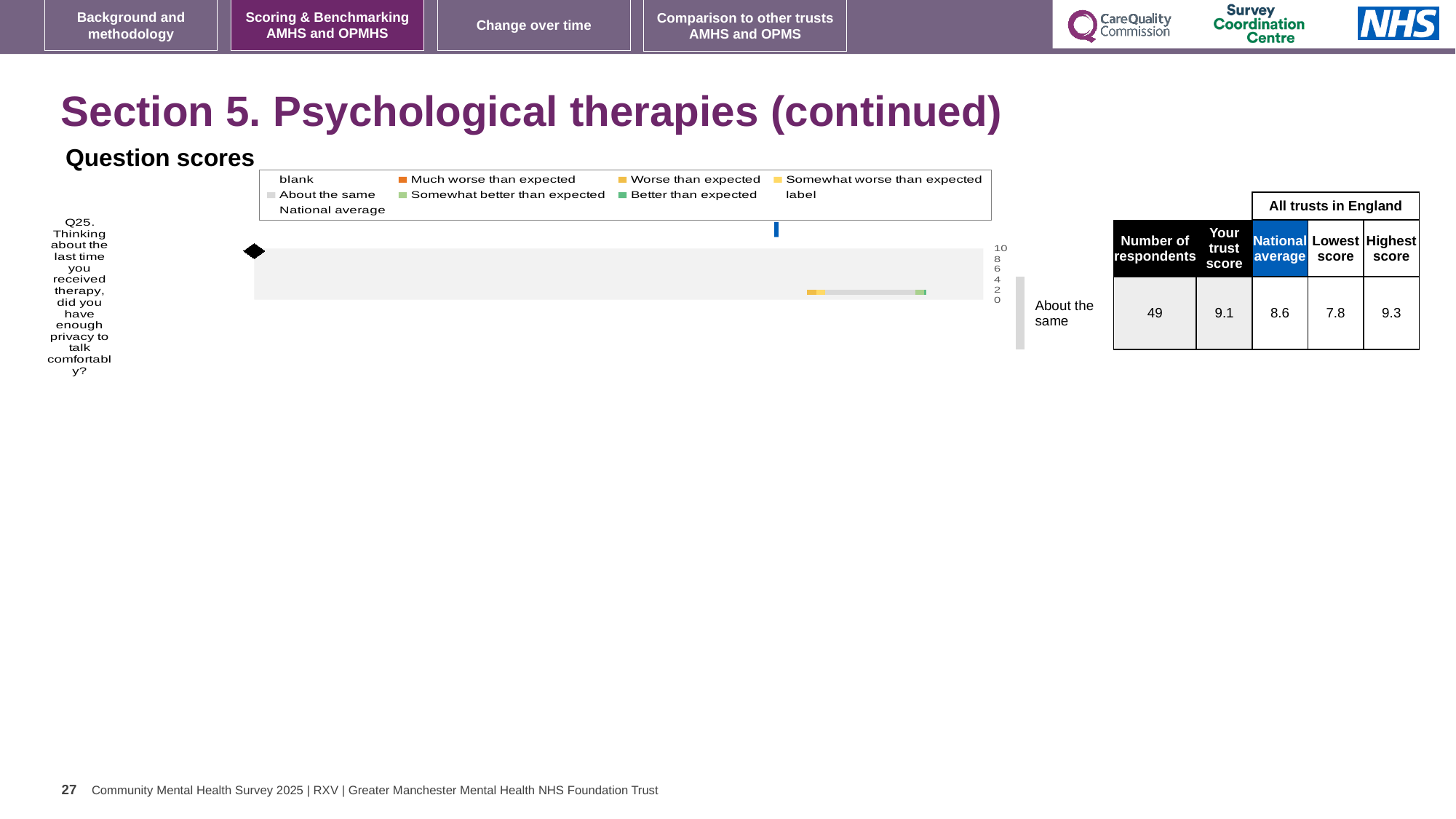
How many entries does the chart legend list? 9 What rating category is shown next to the chart for Q25? About the same In the table beside the chart, which is larger for Q25: the trust score or the national average? trust score What kind of chart is shown on the slide? bar chart In the table beside the chart, what is the trust score for Q25? 9.1 Which question number is plotted on the chart? Q25 In the table beside the chart, what is the number of respondents for Q25? 49 How many questions (categories) are plotted on the chart? 1 What is the highest tick value shown on the chart's axis? 10 In the table beside the chart, what is the national average for Q25? 8.6 In the table beside the chart, what is the difference between the highest score and the lowest score for Q25? 1.5